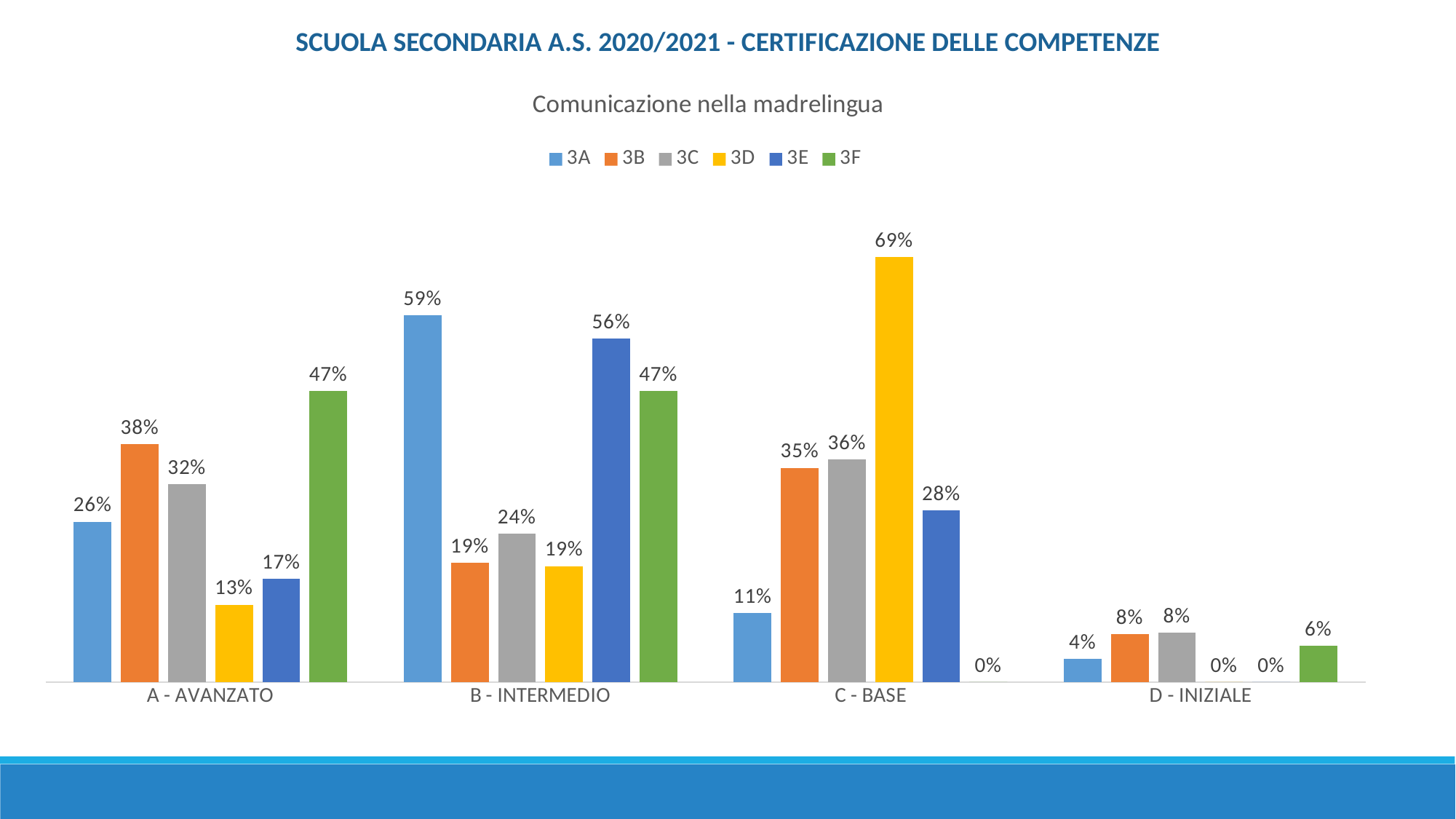
How many series does the legend list? 6 What is the value for 3E in the D - INIZIALE category? 0% What is the value for 3F in the A - AVANZATO category? 47% What is the subtitle of the chart, shown below the main title? Comunicazione nella madrelingua What is the value for 3D in the C - BASE category? 69% What is the value for 3A in the B - INTERMEDIO category? 59% What is the difference between the 3D and 3E values in the C - BASE category? 41% How many categories are shown on the x axis? 4 What kind of chart is shown on the slide? Bar chart Which series has the lowest value in the B - INTERMEDIO category? 3B and 3D (both 19%) Which is larger in the B - INTERMEDIO category: the value for 3A or the value for 3E? 3A Which series has the highest value in the A - AVANZATO category? 3F